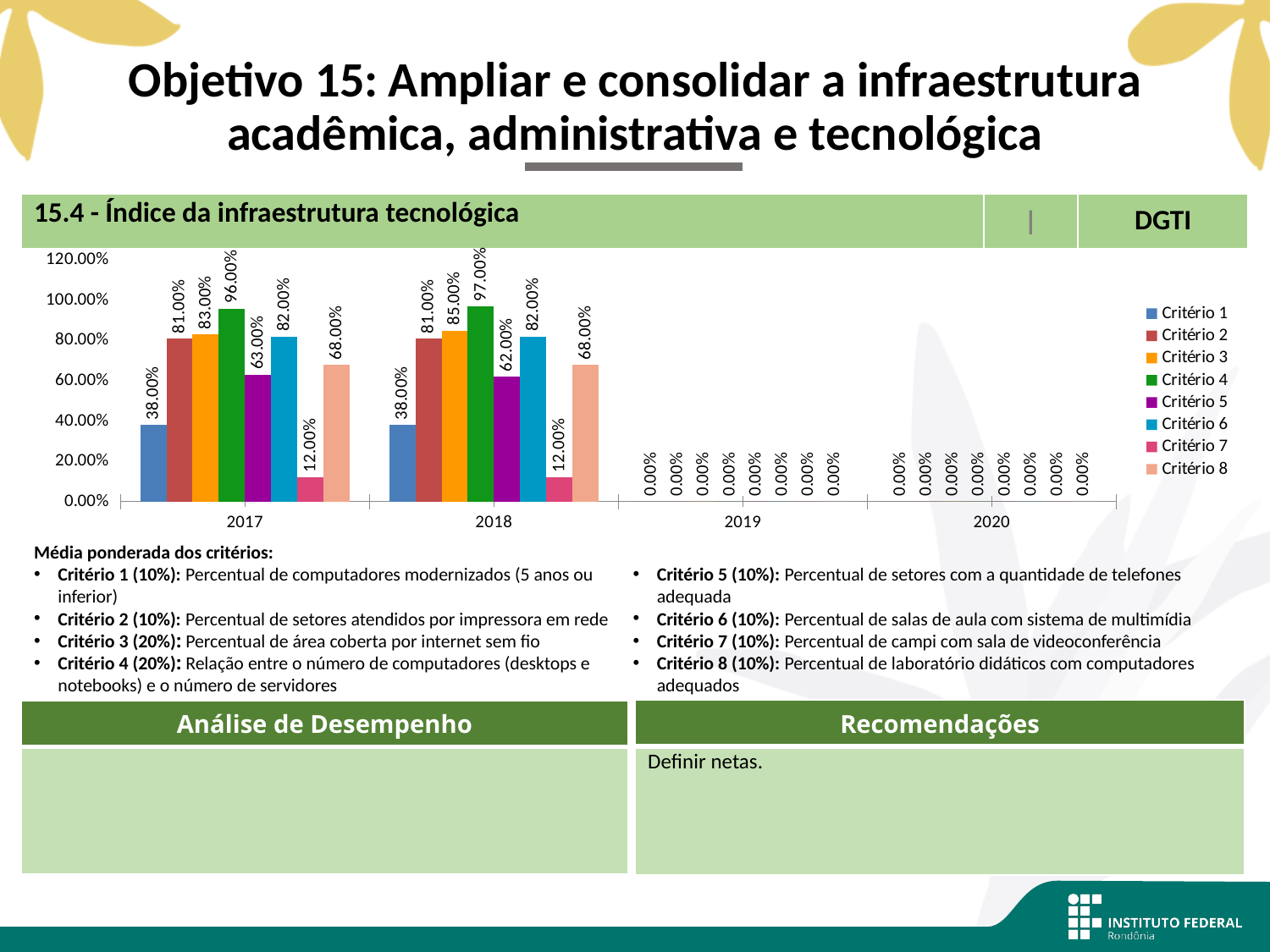
What is the title of the chart section? 15.4 - Índice da infraestrutura tecnológica What is the value for Critério 7 in 2017? 12.00% How many series does the legend list? 8 How many year categories are shown on the x axis? 4 What is the value for Critério 3 in 2018? 85.00% What type of chart is shown on the slide? bar chart What is the value for Critério 4 in 2017? 96.00% What is the difference between Critério 4 and Critério 1 in 2018? 59.00% Which is larger in 2017: Critério 5 or Critério 8? Critério 8 Which criterion has the highest value in 2018? Critério 4 Which criterion has the lowest value in 2017? Critério 7 What is the value for Critério 2 in 2019? 0.00%